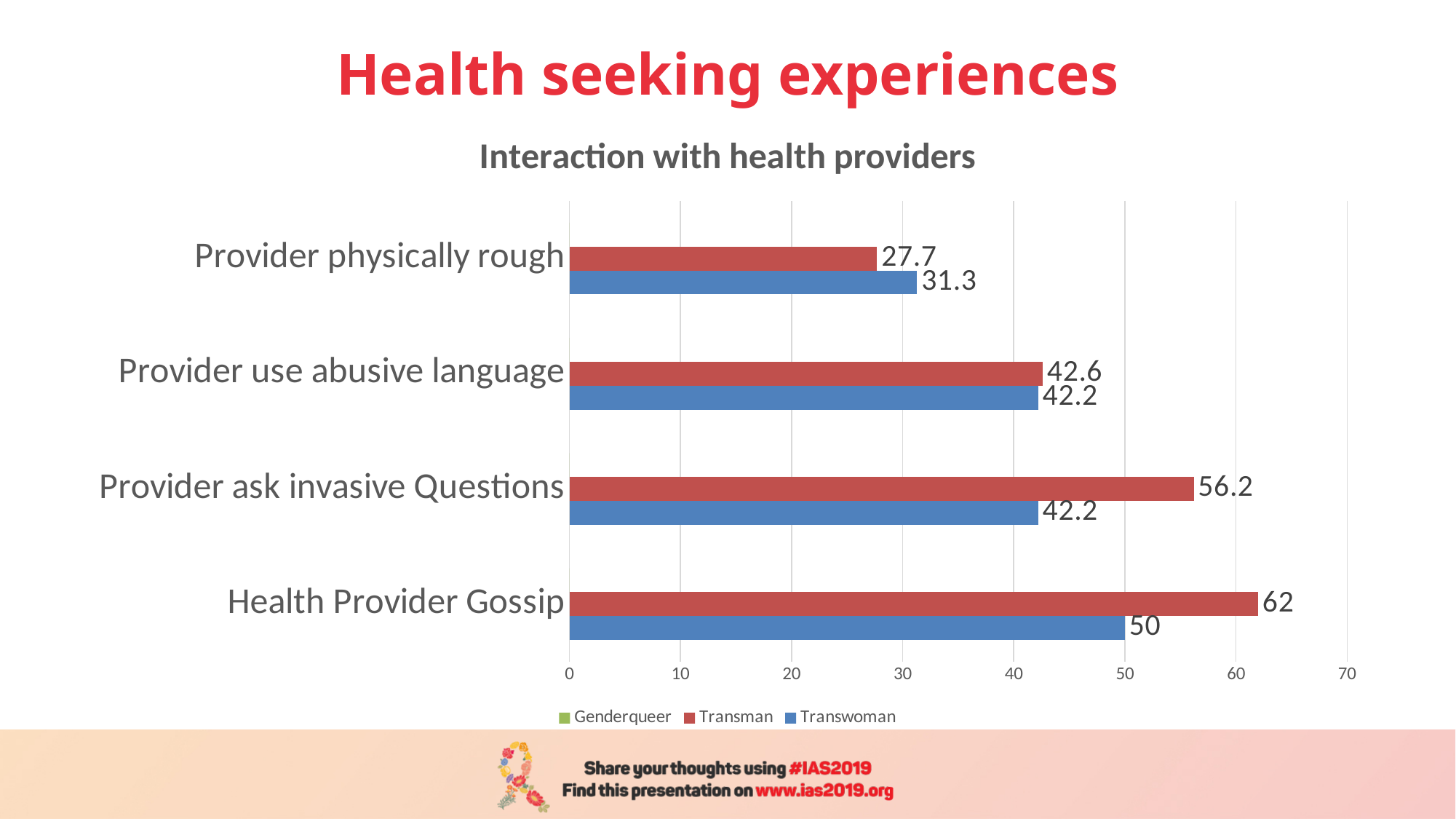
What is the Transwoman value for Provider physically rough? 31.3 Which category has the lowest Transwoman value? Provider physically rough For Provider physically rough, which is larger: the Transman value or the Transwoman value? Transwoman How many categories are shown on the y axis? 4 What is the difference between the Transman and Transwoman values for Provider ask invasive Questions? 14 What kind of chart is shown? Bar chart Which category has the highest Transman value? Health Provider Gossip What is the difference between the Transman and Transwoman values for Health Provider Gossip? 12 What is the Transman value for Provider ask invasive Questions? 56.2 What is the Transman value for Health Provider Gossip? 62 What is the Transwoman value for Provider use abusive language? 42.2 How many series does the legend list? 3